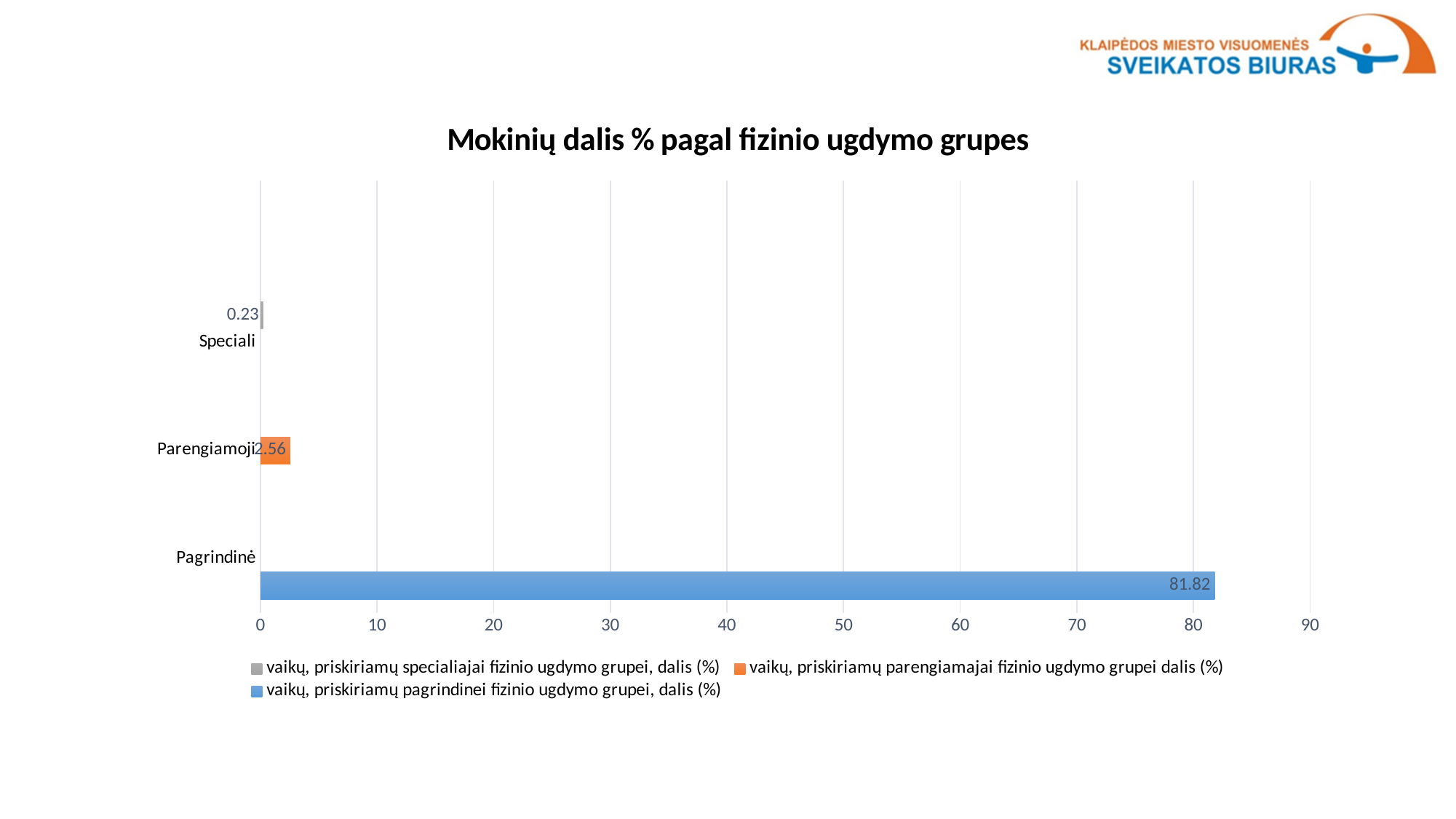
What is the difference between the values for Parengiamoji and Speciali? 2.33 What is the value for Speciali? 0.23 Which category has the highest value? Pagrindinė What is the difference between the values for Pagrindinė and Parengiamoji? 79.26 Which category has the lowest value? Speciali What is the value for Parengiamoji? 2.56 How many series does the legend list? 3 How many categories are shown on the chart? 3 Which is larger, the value for Parengiamoji or the value for Speciali? Parengiamoji What kind of chart is shown on the slide? bar chart What is the value for Pagrindinė? 81.82 Is the value for Pagrindinė greater or less than 80? greater